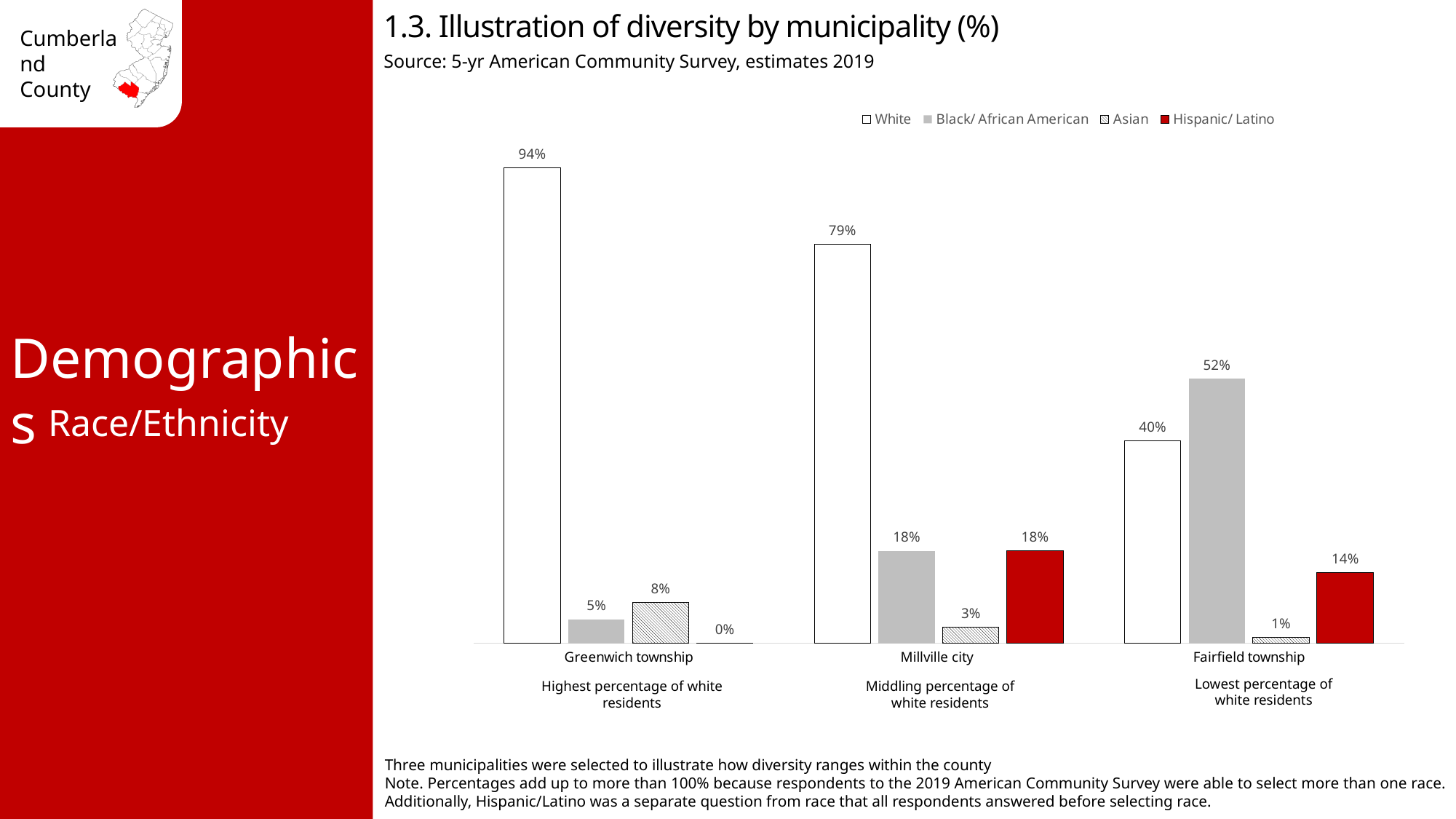
How many municipalities are shown on the x axis? 3 What kind of chart is shown on the slide? Bar chart What is the Hispanic/ Latino percentage for Millville city? 18% Which series is drawn in red? Hispanic/ Latino Which municipality has the lowest Hispanic/ Latino percentage? Greenwich township Which municipality has the highest White percentage? Greenwich township What is the Asian percentage for Fairfield township? 1% What is the difference between the White percentage in Greenwich township and in Millville city? 15% How many series does the legend list? 4 What is the White percentage for Greenwich township? 94% What is the Black/ African American percentage for Fairfield township? 52% Which is larger in Fairfield township: the White percentage or the Black/ African American percentage? Black/ African American